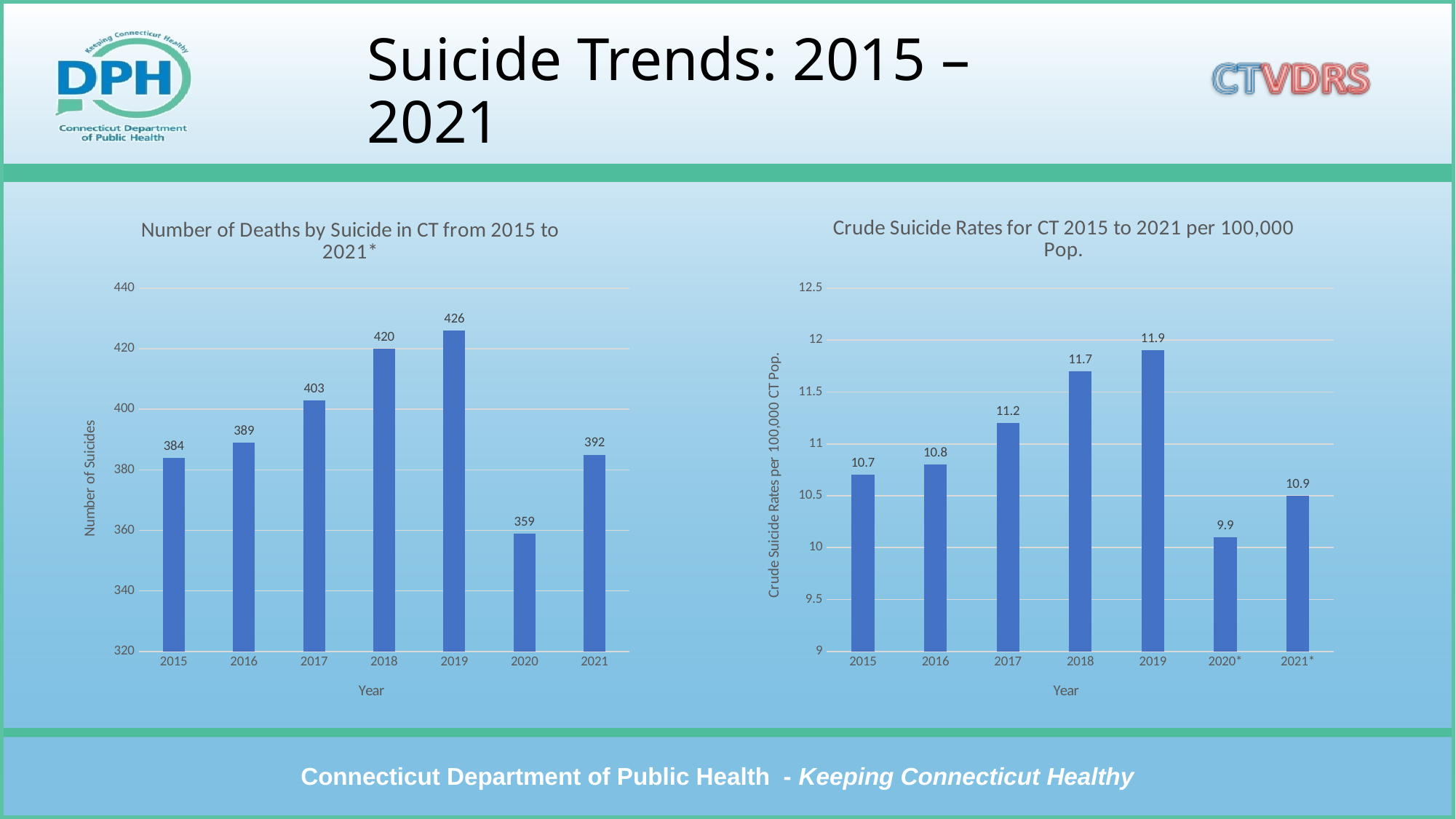
What kind of chart is the chart titled "Number of Deaths by Suicide in CT from 2015 to 2021*"? Bar chart In the chart titled "Crude Suicide Rates for CT 2015 to 2021 per 100,000 Pop.", which year has the lowest crude suicide rate? 2020* In the chart titled "Number of Deaths by Suicide in CT from 2015 to 2021*", what is the difference between the number of suicides in 2019 and in 2020? 67 In the chart titled "Number of Deaths by Suicide in CT from 2015 to 2021*", how many deaths by suicide were there in 2018? 420 In the chart titled "Crude Suicide Rates for CT 2015 to 2021 per 100,000 Pop.", do the crude suicide rates rise or fall from 2015 to 2019? Rise In the chart titled "Number of Deaths by Suicide in CT from 2015 to 2021*", which year had the lowest number of suicides? 2020 In the chart titled "Crude Suicide Rates for CT 2015 to 2021 per 100,000 Pop.", is the crude suicide rate higher in 2018 or in 2016? 2018 In the chart titled "Number of Deaths by Suicide in CT from 2015 to 2021*", which year had the highest number of suicides? 2019 What is the y-axis label of the chart titled "Crude Suicide Rates for CT 2015 to 2021 per 100,000 Pop."? Crude Suicide Rates per 100,000 CT Pop. In the chart titled "Crude Suicide Rates for CT 2015 to 2021 per 100,000 Pop.", what is the crude suicide rate for 2017? 11.2 In the chart titled "Crude Suicide Rates for CT 2015 to 2021 per 100,000 Pop.", which year has the highest crude suicide rate? 2019 In the chart titled "Number of Deaths by Suicide in CT from 2015 to 2021*", how many years are shown on the x axis? 7